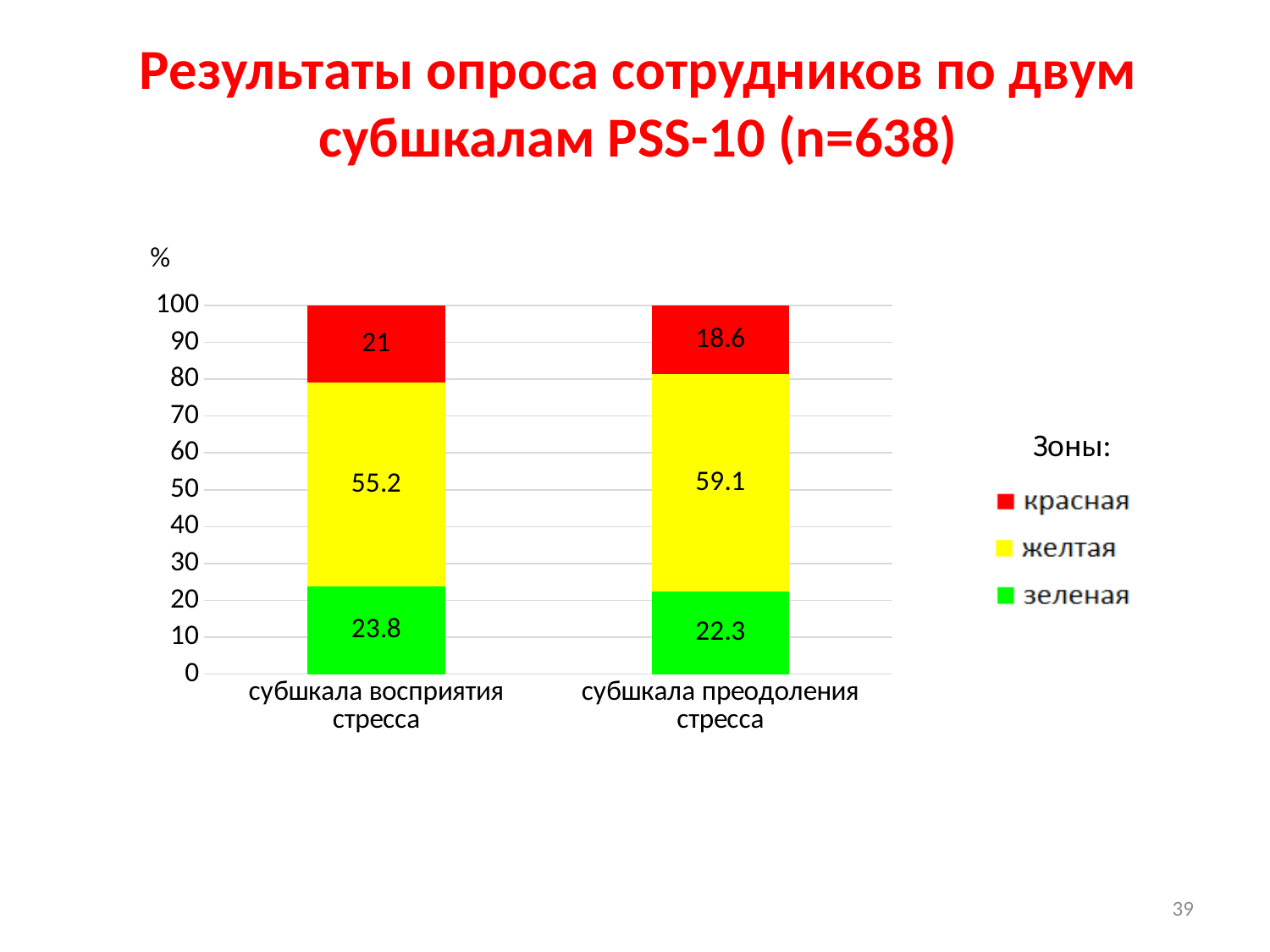
What kind of chart is shown on the slide? stacked bar chart Which zone has the largest share for субшкала преодоления стресса? желтая What is the value of the красная zone for субшкала преодоления стресса? 18.6 What is the value of the зеленая zone for субшкала преодоления стресса? 22.3 What is the value of the зеленая zone for субшкала восприятия стресса? 23.8 Which is larger: the красная zone for субшкала восприятия стресса or for субшкала преодоления стресса? субшкала восприятия стресса How many series does the legend list? 3 What is the difference between the желтая zone values for субшкала преодоления стресса and субшкала восприятия стресса? 3.9 Which zone has the smallest share for субшкала преодоления стресса? красная How many categories are shown on the x axis? 2 What is the value of the желтая zone for субшкала восприятия стресса? 55.2 What is the total of the stacked bar for субшкала восприятия стресса? 100